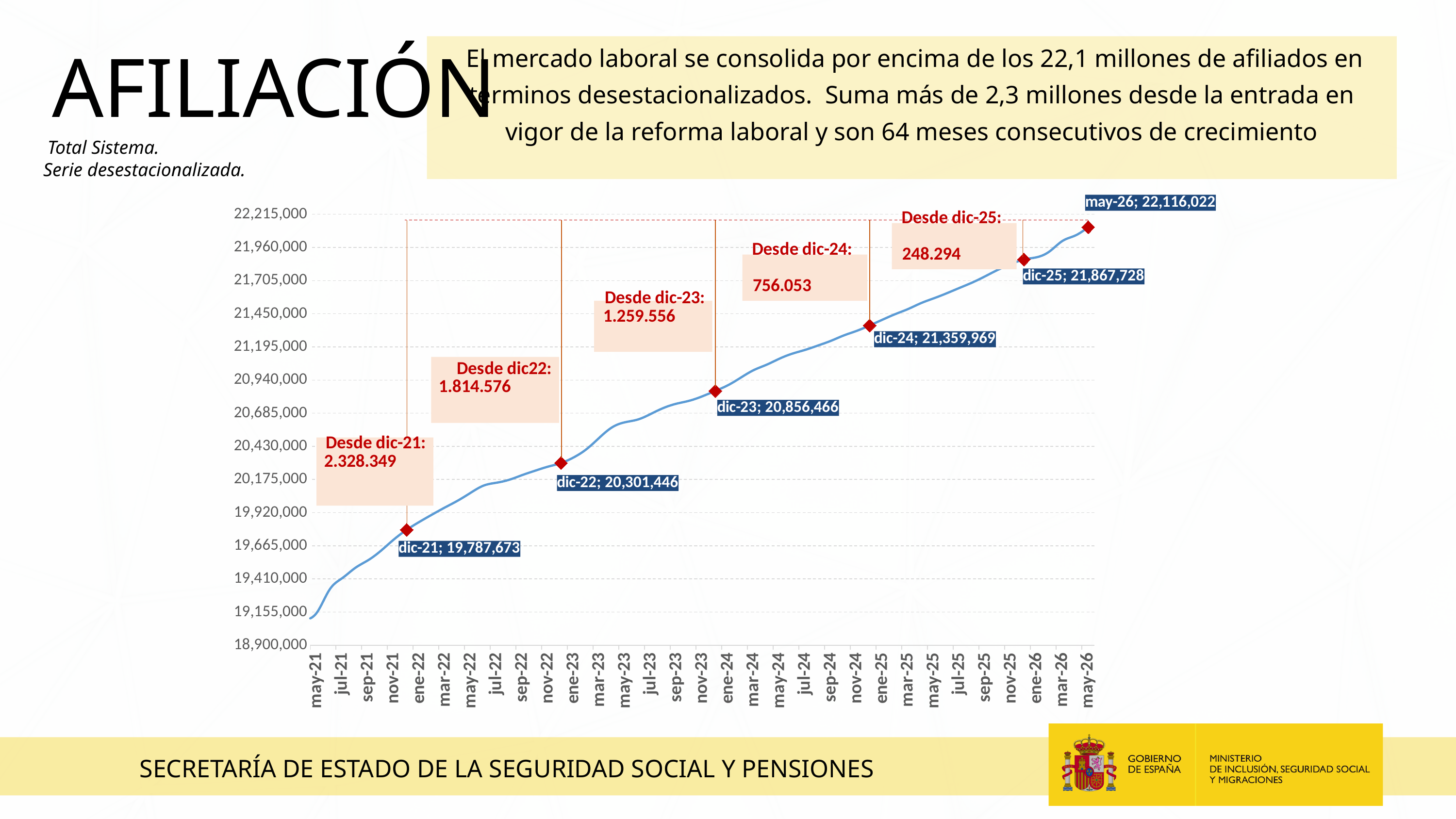
What is the value labelled for dic-21? 19,787,673 What is the difference between the labelled values for may-26 and dic-25? 248,294 What is the value labelled for dic-23? 20,856,466 Do the values rise or fall from may-21 to may-26? rise How many data points carry a value label on the chart? 6 Is the value for sep-24 greater or less than 21,450,000? less What is the value labelled for may-26? 22,116,022 Which labelled point has the lowest value? dic-21 What is the value labelled for dic-25? 21,867,728 What type of chart is shown on the slide? line chart Which labelled point has the highest value? may-26 What is the difference between the labelled values for dic-22 and dic-21? 513,773